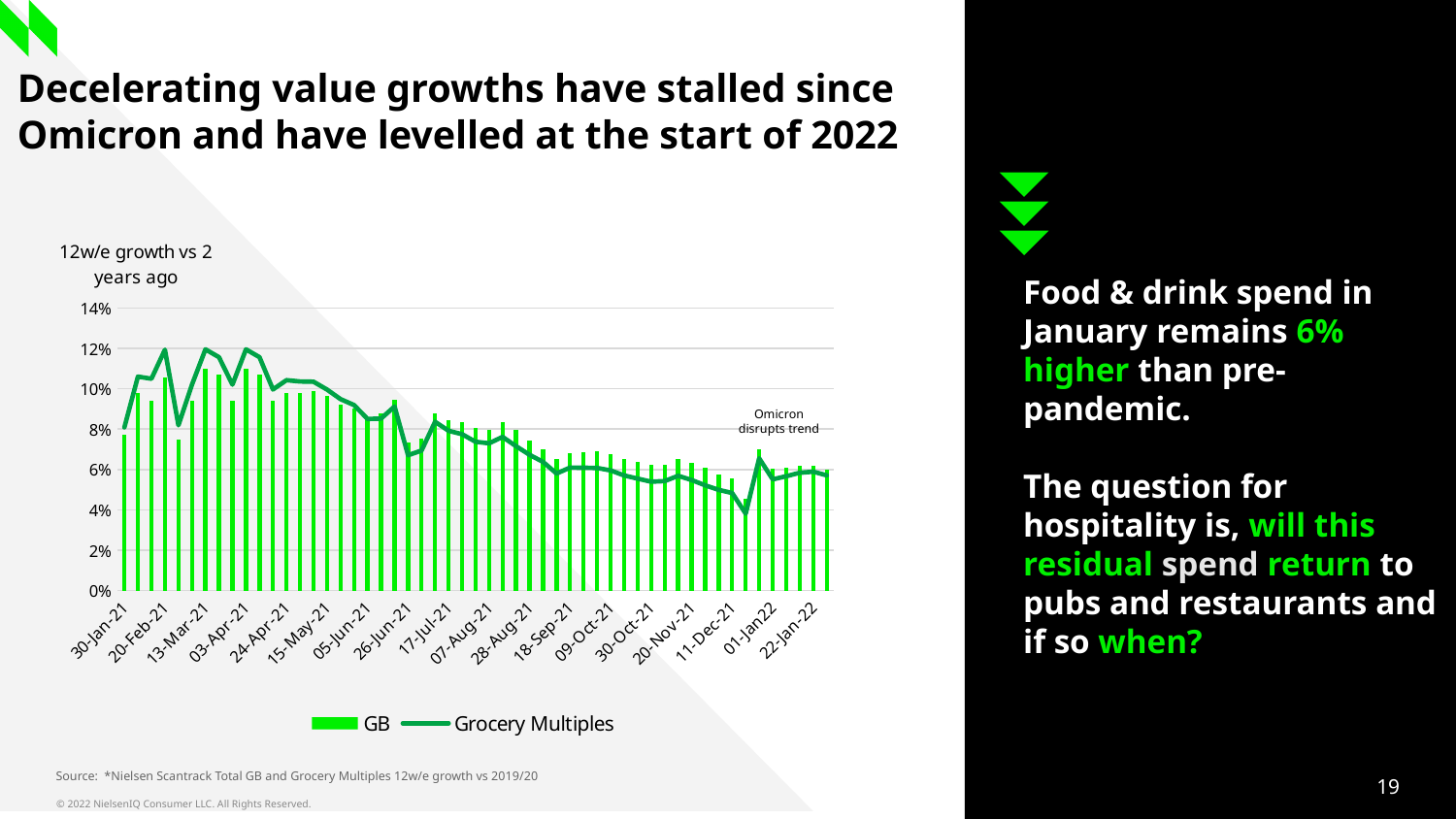
Is the Grocery Multiples value at 13-Mar-21 greater or less than 10%? greater Which is larger: the GB value at 20-Feb-21 or at 11-Dec-21? 20-Feb-21 Is the GB value at 22-Jan-22 greater or less than 8%? less Which series is plotted as bars and which as a line? GB is bars; Grocery Multiples is a line Which two series are listed in the chart legend? GB and Grocery Multiples Do the values generally rise or fall from 30-Jan-21 to 22-Jan-22? Fall What is the highest value shown on the chart's vertical axis? 14% How many series does the chart legend list? 2 Is the GB value at 03-Apr-21 greater or less than 10%? greater What type of chart is shown on the slide? A combined bar and line chart Which is larger: the Grocery Multiples value at 13-Mar-21 or at 22-Jan-22? 13-Mar-21